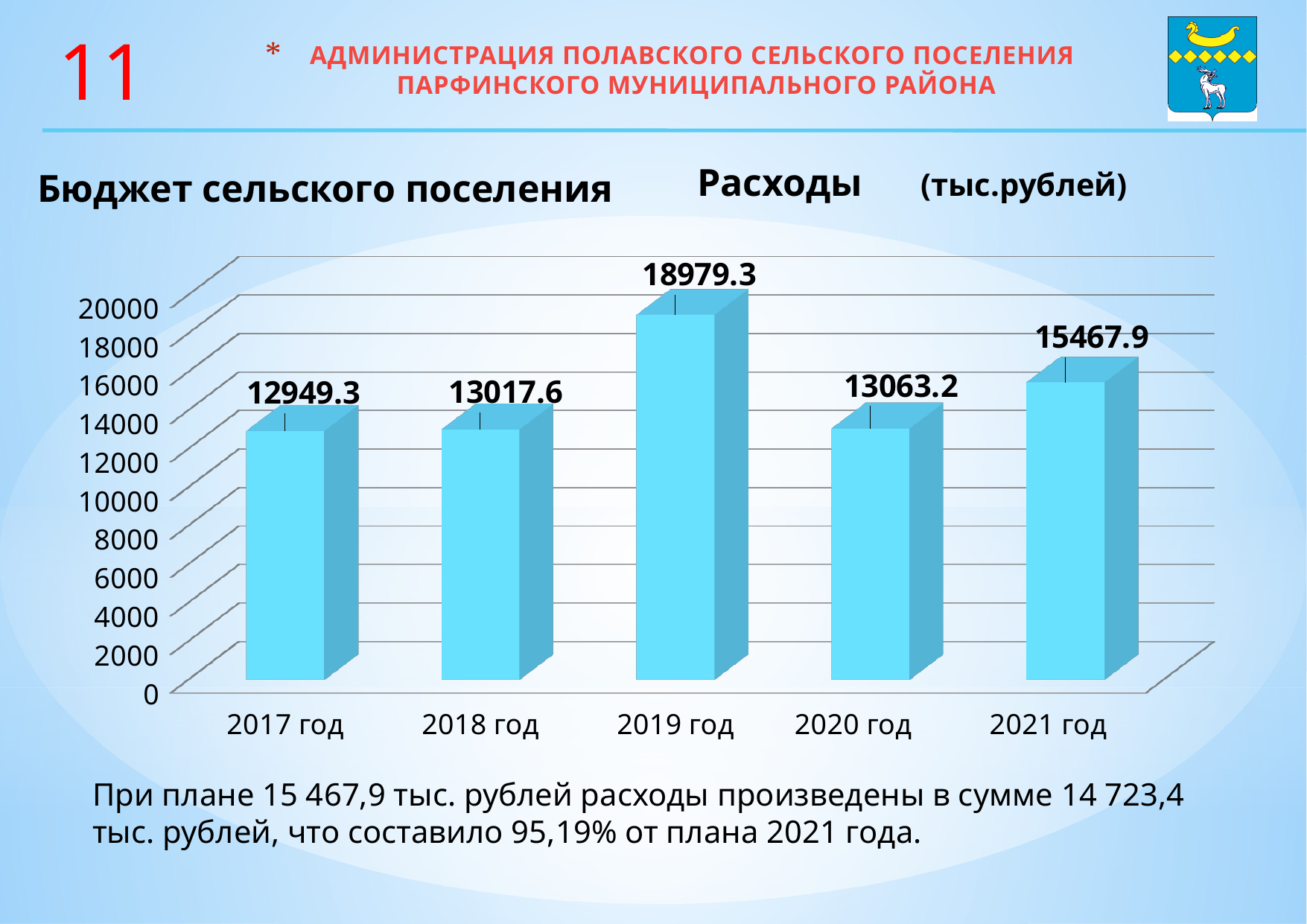
How many years are shown on the x axis? 5 What is the value for 2019 год? 18979.3 What is the difference between the values for 2019 год and 2017 год? 6030.0 Which year has the highest value? 2019 год Which year has the lowest value? 2017 год What is the value for 2021 год? 15467.9 Does the value rise or fall from 2019 год to 2020 год? fall What is the difference between the values for 2021 год and 2020 год? 2404.7 Which is larger, the value for 2021 год or the value for 2020 год? 2021 год Is the value for 2019 год greater or less than 18000? greater What is the value for 2017 год? 12949.3 What kind of chart is shown on the slide? bar chart